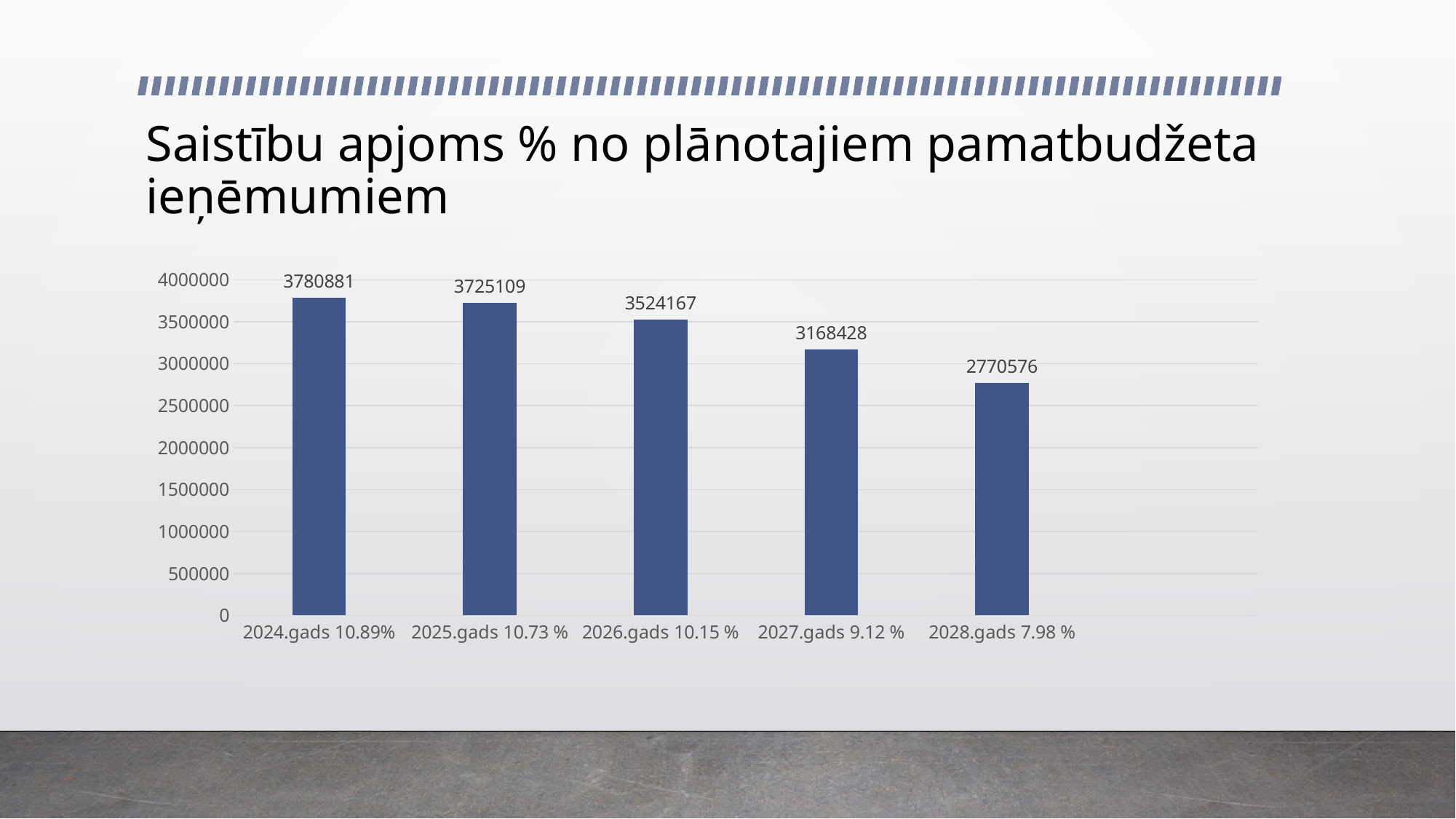
Which category has the lowest value? 2028.gads 7.98 % How many bars are shown in the chart? 5 Do the values rise or fall from 2024.gads to 2028.gads? fall Is the value for 2027.gads 9.12 % greater or less than 3000000? greater What is the value for 2024.gads 10.89%? 3780881 Which category has the highest value? 2024.gads 10.89% What kind of chart is shown on the slide? bar chart What is the value for 2026.gads 10.15 %? 3524167 Which is larger, the value for 2026.gads 10.15 % or the value for 2027.gads 9.12 %? 2026.gads 10.15 % What is the difference between the values for 2024.gads 10.89% and 2025.gads 10.73 %? 55772 What is the value for 2028.gads 7.98 %? 2770576 What is the difference between the values for 2027.gads 9.12 % and 2028.gads 7.98 %? 397852